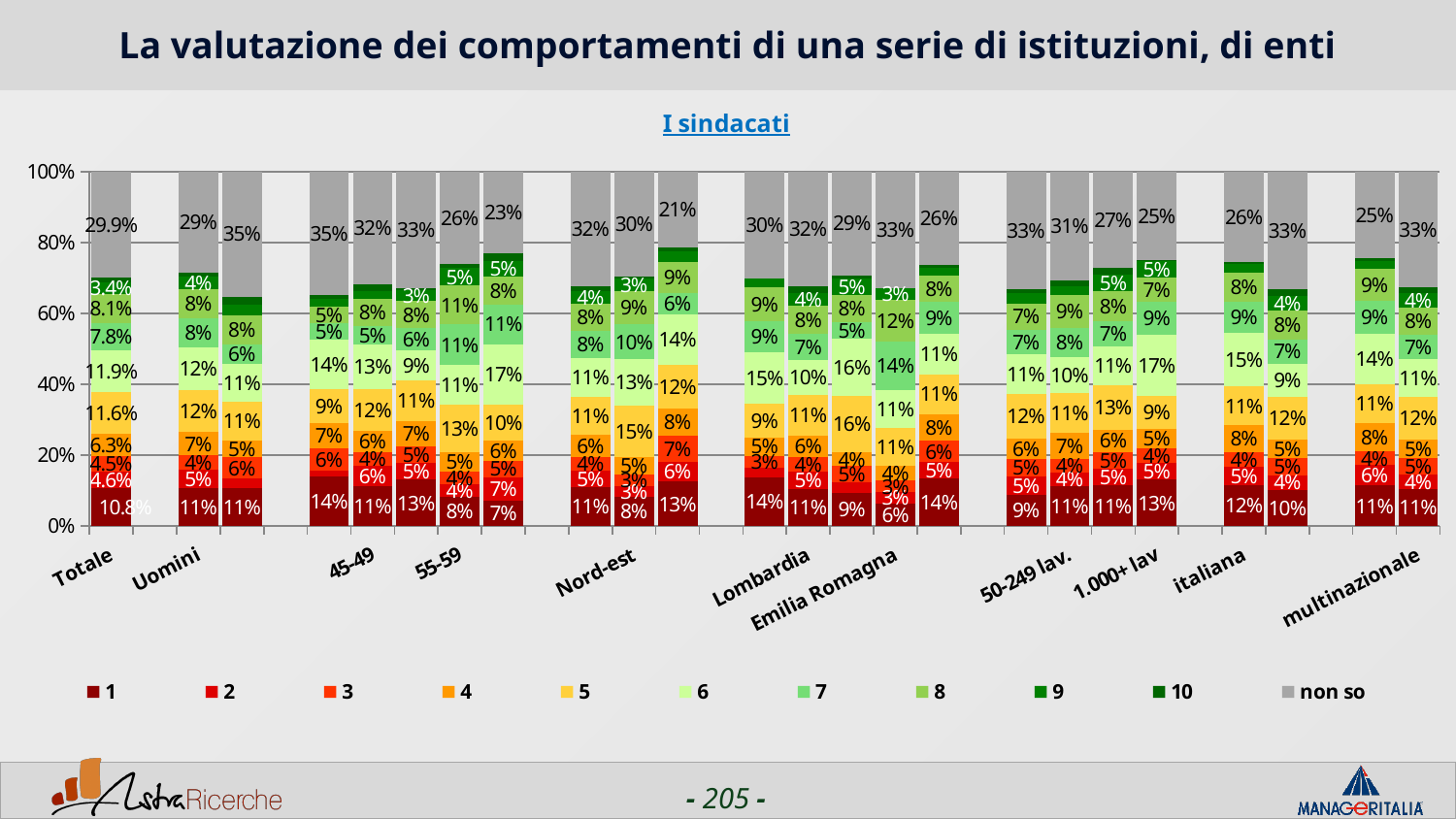
What is the 'non so' share for Uomini? 29% What is the last entry in the legend? non so What is the 'non so' share for Totale? 29.9% What is the value for rating 5 in the Uomini bar? 12% What is the value for rating 1 in the Totale bar? 10.8% In the Totale bar, which is larger: the value for rating 5 or the value for rating 4? Rating 5 What is the value for rating 1 in the Uomini bar? 11% What is the subtitle of the chart? I sindacati In the Totale bar, what is the difference between the value for rating 6 and the value for rating 7? 4.1 percentage points What is the value for rating 9 in the Totale bar? 3.4% What kind of chart is shown on the slide? Stacked bar chart How many series does the legend list? 11